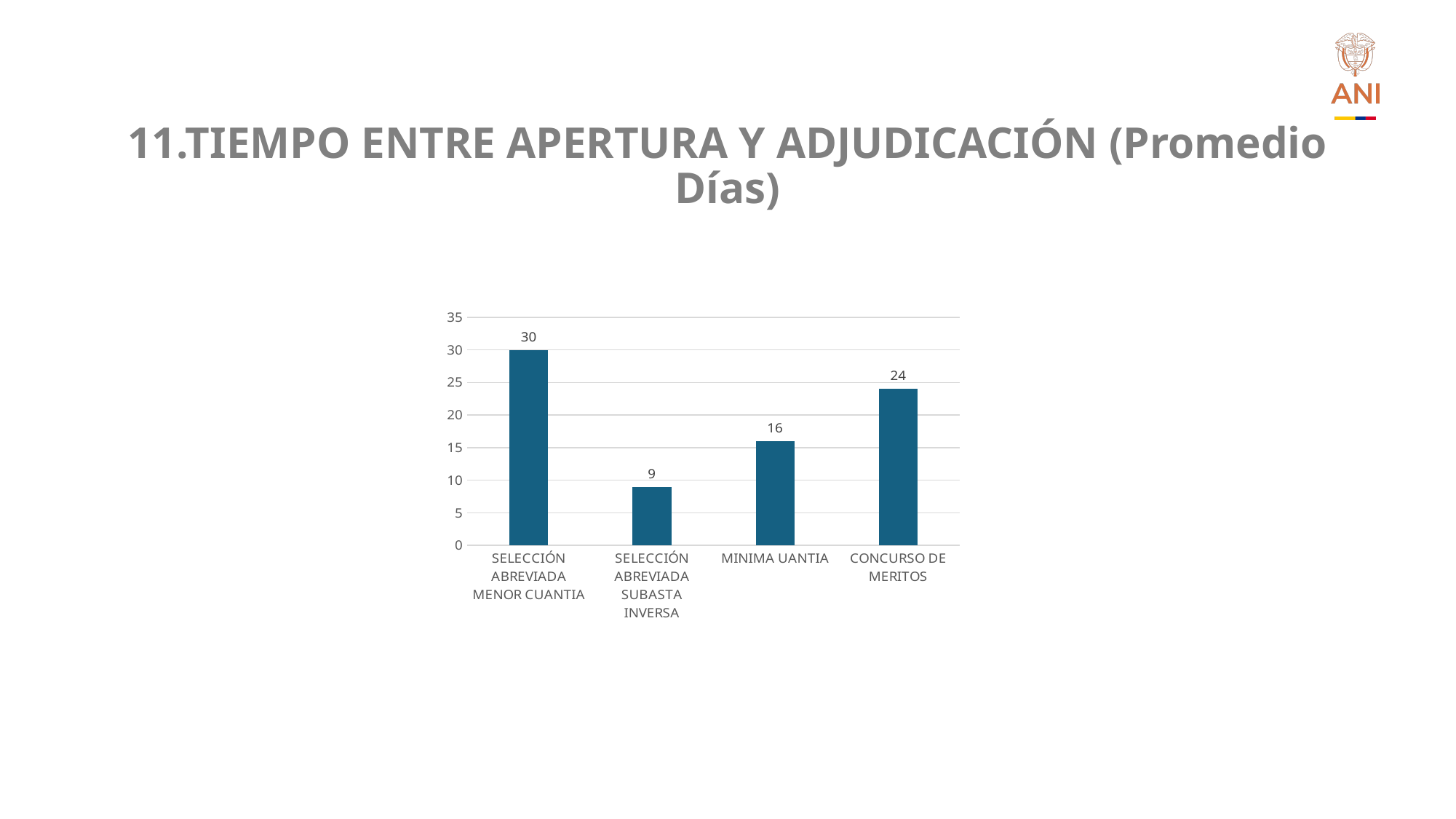
Is the value for MINIMA UANTIA greater or less than 20? less What is the value for SELECCIÓN ABREVIADA MENOR CUANTIA? 30 What is the value for SELECCIÓN ABREVIADA SUBASTA INVERSA? 9 How many categories are shown in the chart? 4 Which is larger, the value for MINIMA UANTIA or the value for CONCURSO DE MERITOS? CONCURSO DE MERITOS What is the value for CONCURSO DE MERITOS? 24 What is the value for MINIMA UANTIA? 16 What is the title of the slide? 11.TIEMPO ENTRE APERTURA Y ADJUDICACIÓN (Promedio Días) What kind of chart is shown on the slide? bar chart Which category has the highest value? SELECCIÓN ABREVIADA MENOR CUANTIA Which category has the lowest value? SELECCIÓN ABREVIADA SUBASTA INVERSA What is the difference between the values for SELECCIÓN ABREVIADA MENOR CUANTIA and CONCURSO DE MERITOS? 6